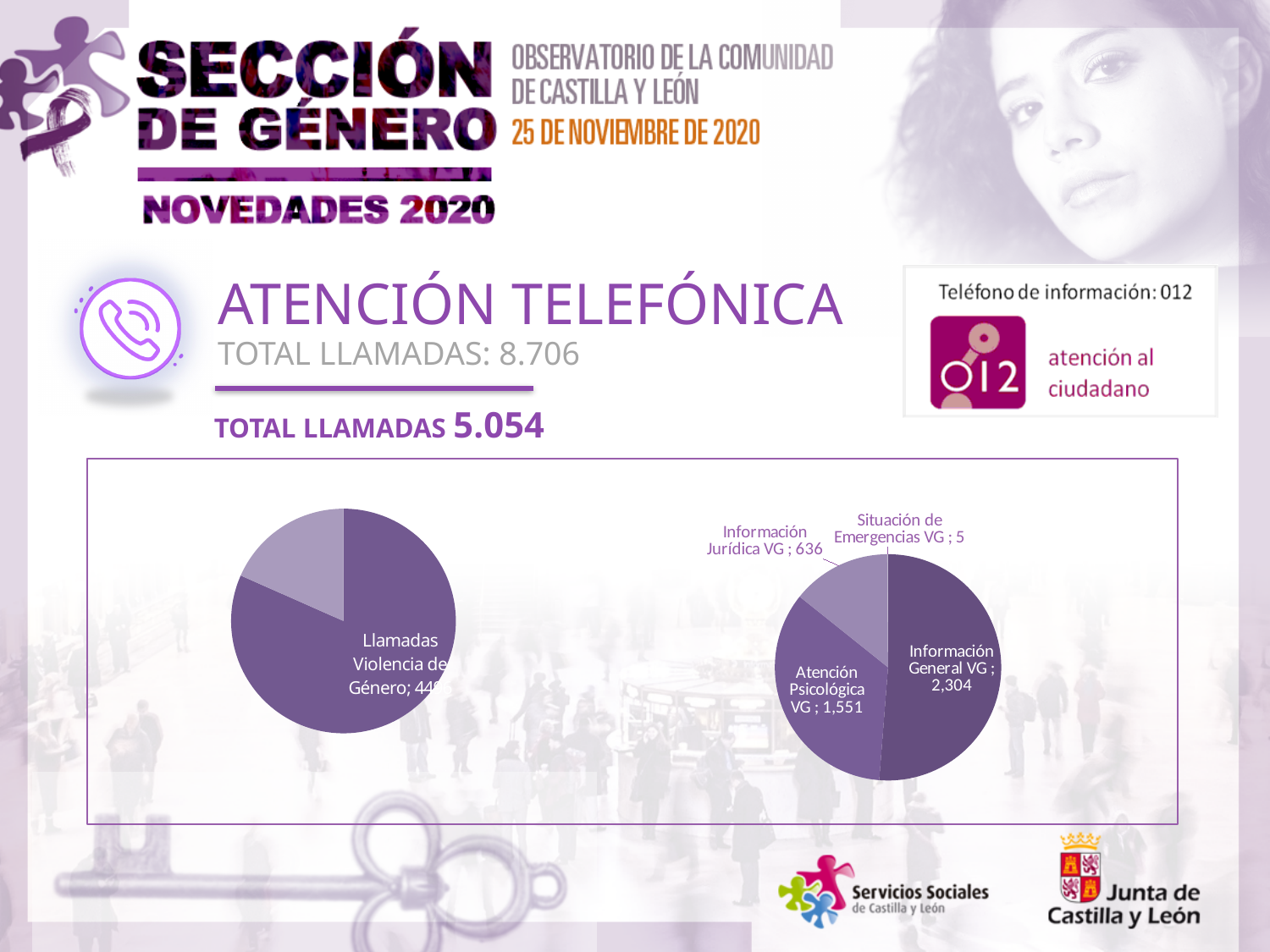
On the right pie chart, what is the value for Situación de Emergencias VG? 5 On the right pie chart, what is the difference between Información General VG and Atención Psicológica VG? 753 On the left pie chart, what is the label of the largest slice? Llamadas Violencia de Género On the right pie chart, which category has the smallest value? Situación de Emergencias VG On the right pie chart, which is larger: Atención Psicológica VG or Información Jurídica VG? Atención Psicológica VG On the right pie chart, what is the value for Información General VG? 2,304 On the right pie chart, what is the value for Atención Psicológica VG? 1,551 How many slices does the right pie chart have? 4 What kind of chart is the chart on the left of the slide? Pie chart On the right pie chart, which category has the largest value? Información General VG How many slices does the left pie chart have? 3 On the right pie chart, what is the value for Información Jurídica VG? 636